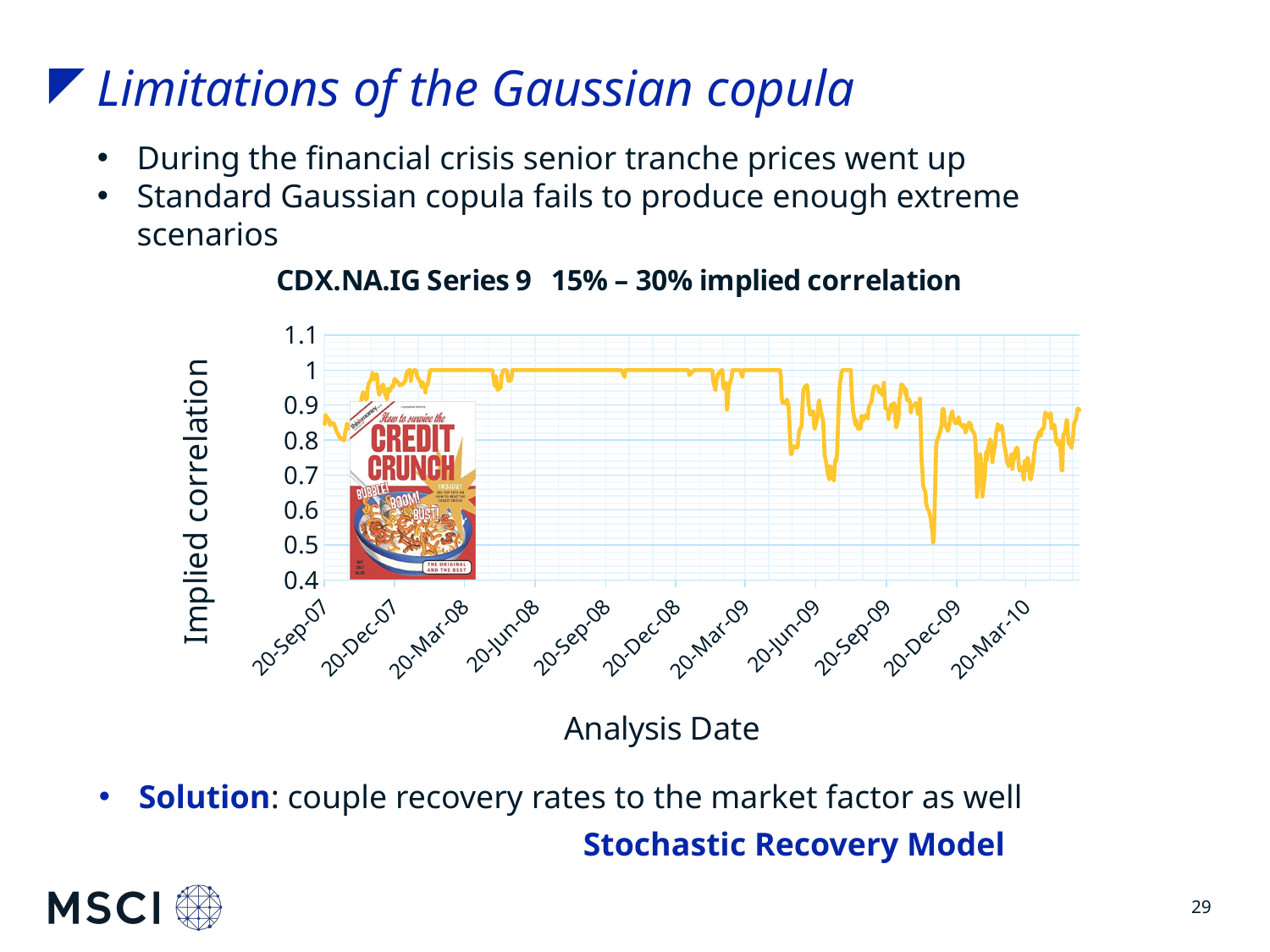
Is the implied correlation at 20-Dec-08 greater or less than 0.8? greater Is the lowest value of the line on the chart greater or less than 0.6? less What is the highest value the line reaches on the chart? 1 Is the implied correlation at 20-Sep-08 greater or less than 0.9? greater What is the label of the vertical axis of the chart? Implied correlation What is the last date label on the x axis of the chart? 20-Mar-10 How many date labels are shown on the x axis of the chart? 11 Between 20-Jun-08 and 20-Dec-09, does the implied correlation overall rise or fall? fall What is the title of the chart? CDX.NA.IG Series 9 15% – 30% implied correlation What is the first date label on the x axis of the chart? 20-Sep-07 What kind of chart is shown on the slide? Line chart